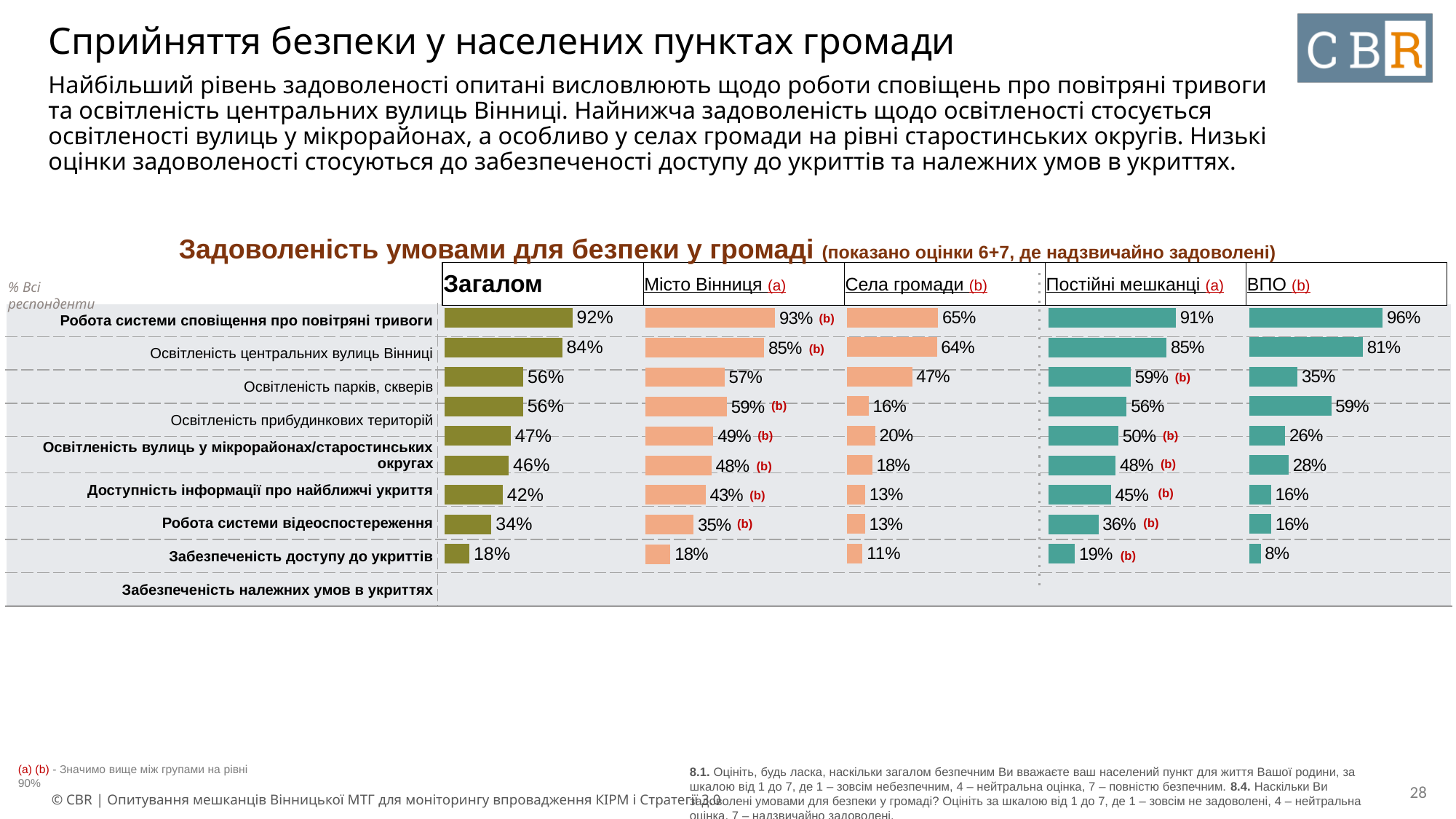
What is the Села громади (b) value for 'Освітленість центральних вулиць Вінниці'? 64% For 'Робота системи сповіщення про повітряні тривоги', what is the difference between Місто Вінниця (a) and Села громади (b)? 28 percentage points How many respondent groups (columns) are shown in the chart? 5 What type of chart is used on the slide? Bar chart Which item has the highest Загалом value? Робота системи сповіщення про повітряні тривоги What is the ВПО (b) value for 'Робота системи сповіщення про повітряні тривоги'? 96% What is the Постійні мешканці (a) value for 'Робота системи сповіщення про повітряні тривоги'? 91% What is the title of the chart? Задоволеність умовами для безпеки у громаді What is the lowest value shown in the Загалом column? 18% For 'Робота системи сповіщення про повітряні тривоги', what is the difference between ВПО (b) and Постійні мешканці (a)? 5 percentage points For 'Освітленість центральних вулиць Вінниці', which group has the larger value: Постійні мешканці (a) or ВПО (b)? Постійні мешканці (a) What is the Загалом value for 'Робота системи сповіщення про повітряні тривоги'? 92%